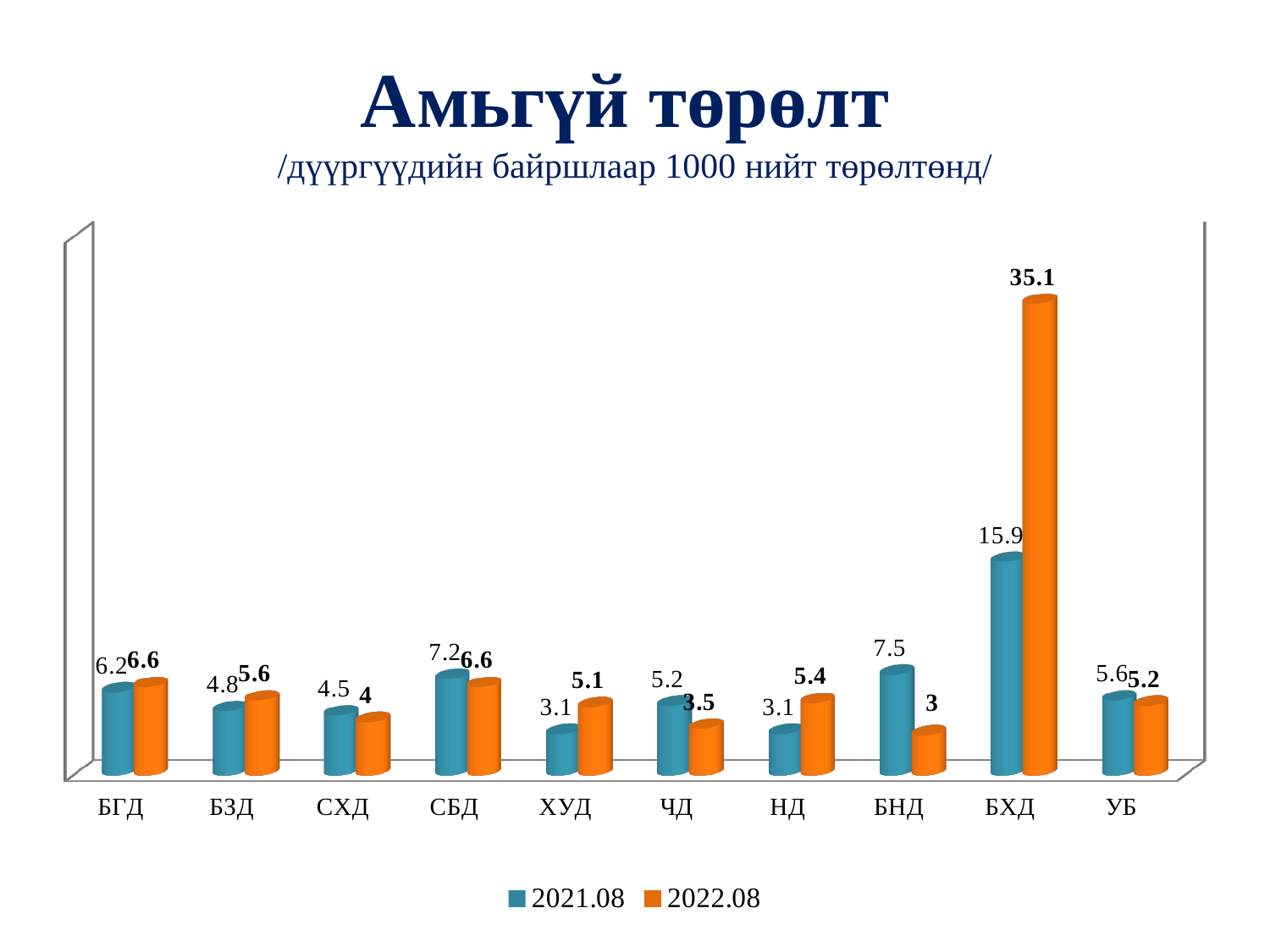
What is the value for БНД in the 2021.08 series? 7.5 What is the title of the chart? Амьгүй төрөлт What is the difference between the 2021.08 and 2022.08 values for БНД? 4.5 Which is larger for СБД: the 2021.08 value or the 2022.08 value? 2021.08 What is the value for ХУД in the 2022.08 series? 5.1 What is the value for БХД in the 2022.08 series? 35.1 How many categories are shown on the x axis? 10 What is the difference between the 2022.08 and 2021.08 values for БХД? 19.2 Which category has the lowest value in the 2022.08 series? БНД What kind of chart is shown on the slide? Bar chart How many series does the legend list? 2 Which category has the highest value in the 2021.08 series? БХД